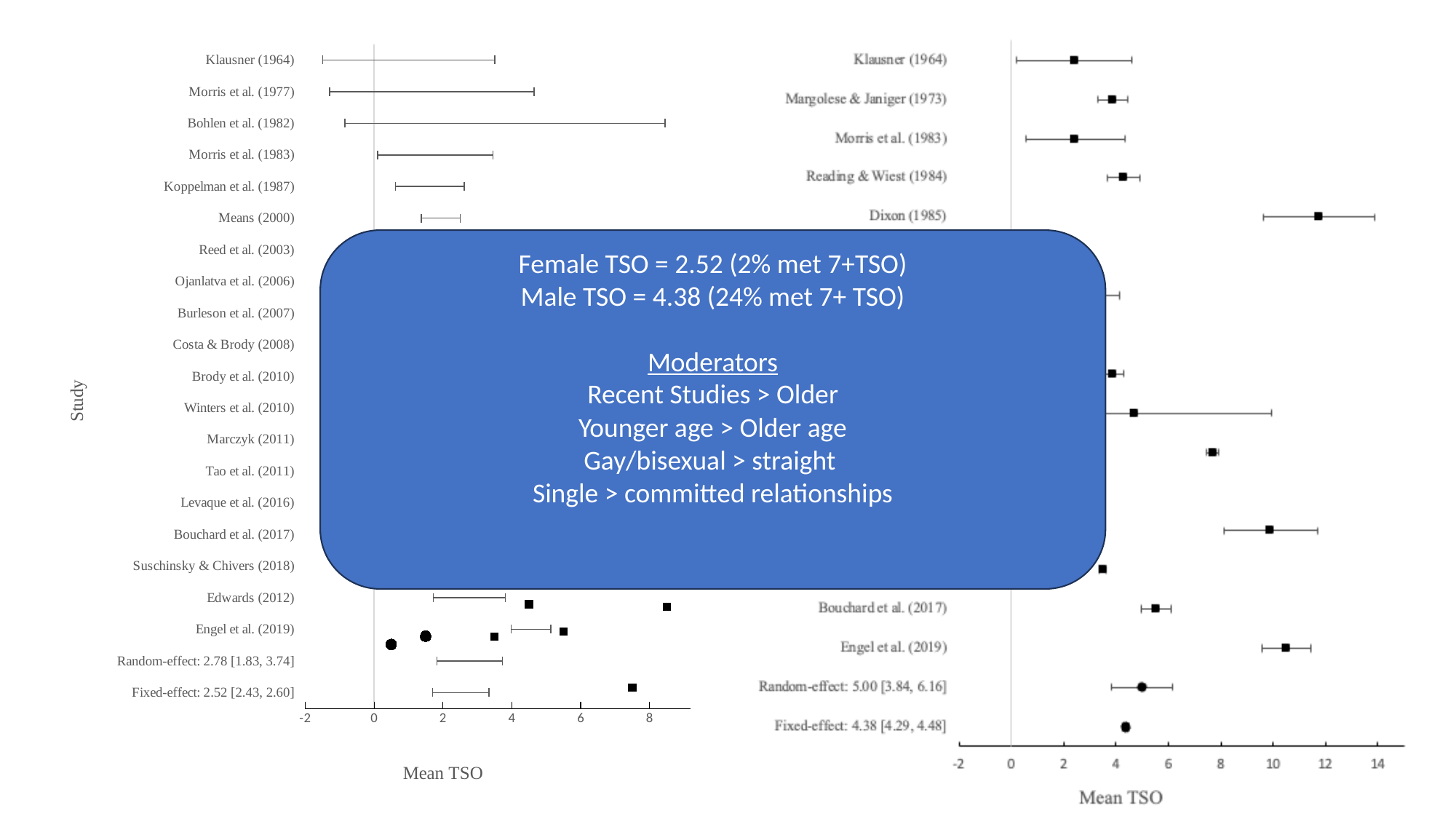
Which chart has the larger fixed-effect estimate, the left chart or the right chart? Right chart On the right chart, what is the random-effect pooled Mean TSO estimate? 5.00 On the right chart, is the Mean TSO value for Dixon (1985) greater or less than 10? greater What is the difference between the fixed-effect estimate on the right chart (4.38) and the fixed-effect estimate on the left chart (2.52)? 1.86 On the right chart, what is the lower bound of the confidence interval for the random-effect estimate? 3.84 On the right chart, what is the fixed-effect pooled Mean TSO estimate? 4.38 On the right chart, is the Mean TSO value for Klausner (1964) greater or less than 4? less On the left chart, what is the fixed-effect pooled Mean TSO estimate? 2.52 What is the difference between the random-effect estimates of the right chart (5.00) and the left chart (2.78)? 2.22 On the right chart, is the Mean TSO value for Engel et al. (2019) greater or less than 8? greater What is the x-axis label on the left chart? Mean TSO On the left chart, what is the random-effect pooled Mean TSO estimate? 2.78